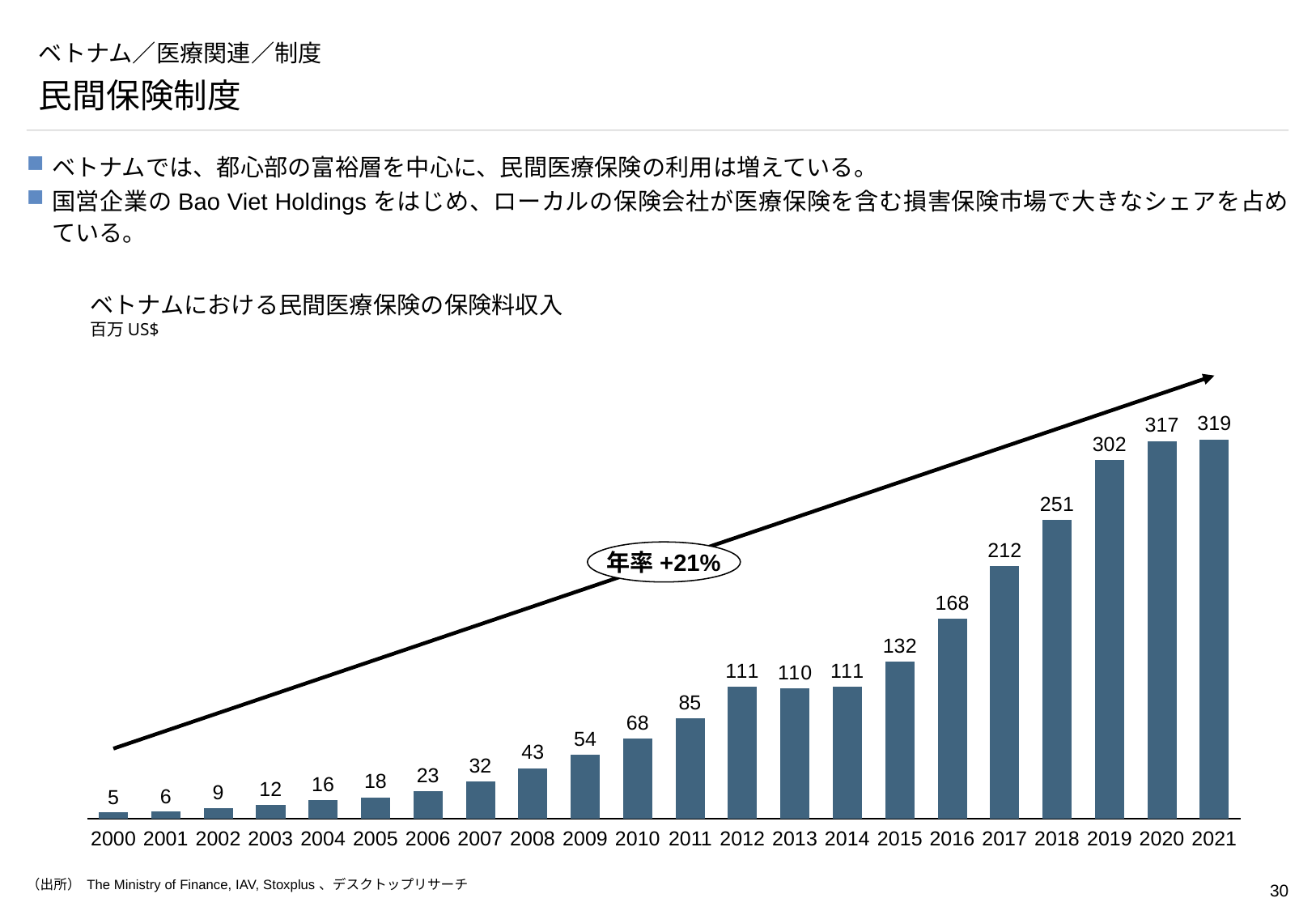
What unit is stated under the chart title? 百万 US$ Which is larger, the value for 2012 or the value for 2013? 2012 What kind of chart is this? bar chart How many years are shown on the x axis? 22 Which year has the highest value? 2021 Which year has the lowest value? 2000 What annual growth rate is shown in the label on the arrow? 年率 +21% Do the values generally rise or fall from 2000 to 2021? rise What is the difference between the values for 2019 and 2018? 51 What is the value for 2021? 319 What is the value for 2000? 5 What is the value for 2010? 68